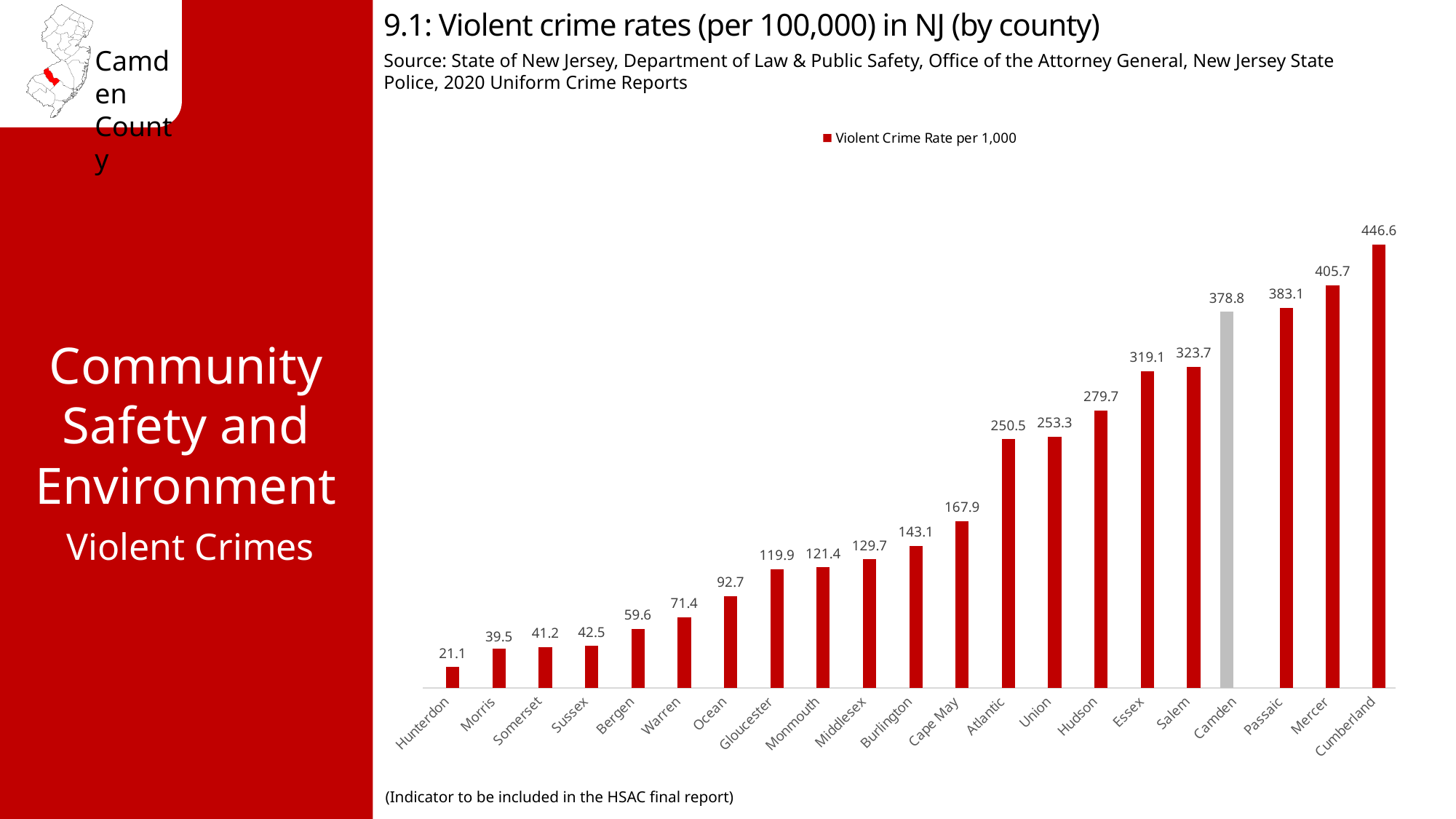
What is the difference between the violent crime rates of Cumberland and Hunterdon? 425.5 What is the difference between the violent crime rates of Mercer and Camden? 26.9 Which county has the highest violent crime rate? Cumberland How many counties are shown on the chart? 21 What type of chart is shown on the slide? Bar chart Which county's bar is shown in grey instead of red? Camden What is the violent crime rate for Hudson County? 279.7 What is the violent crime rate for Gloucester County? 119.9 Do the values rise or fall from left to right along the x axis? Rise Which county has the lowest violent crime rate? Hunterdon Which county has a higher violent crime rate, Essex or Atlantic? Essex What is the violent crime rate for Camden County? 378.8